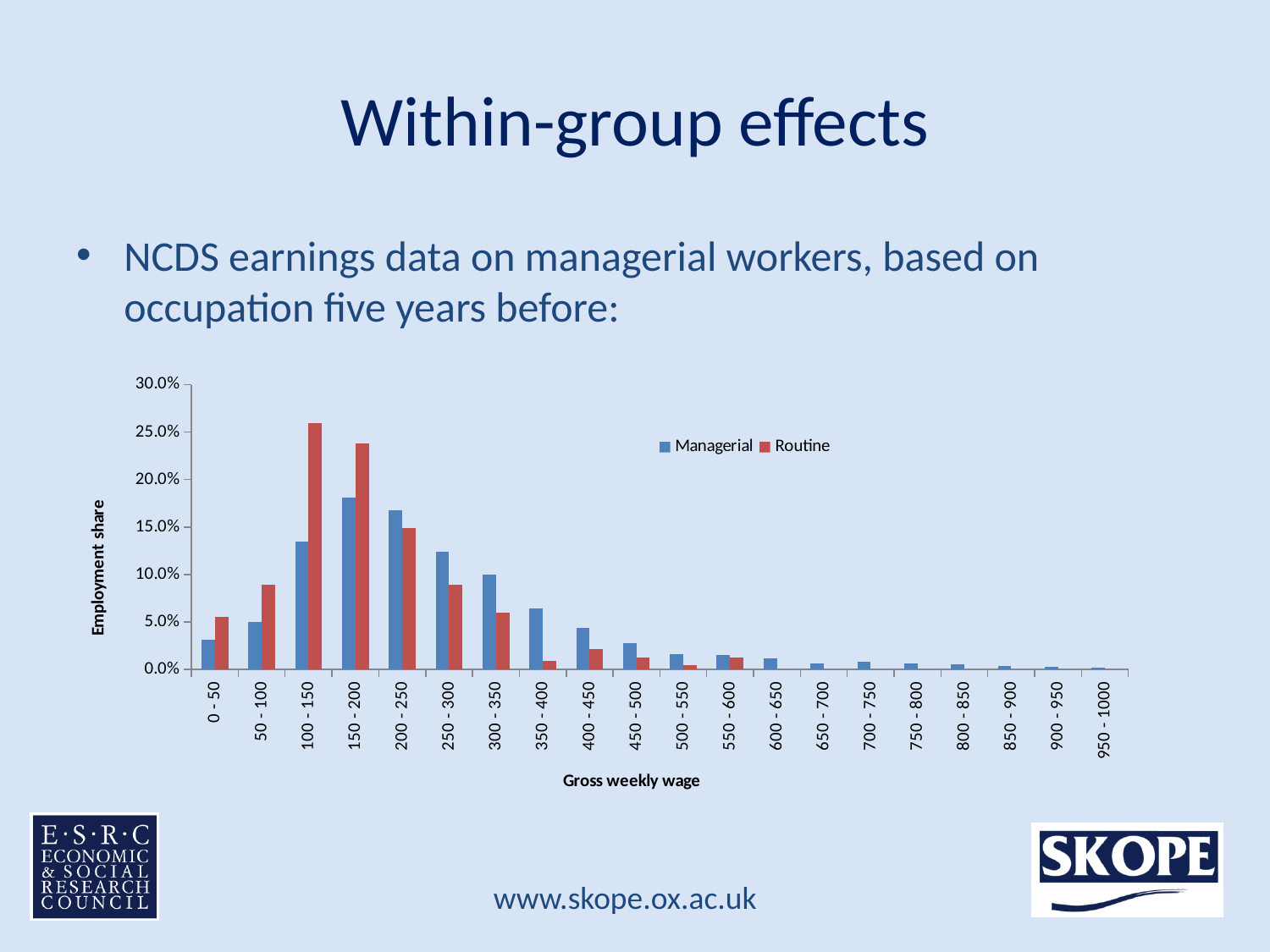
What is the label of the chart's horizontal axis? Gross weekly wage Which wage category has the highest employment share for the Routine series? 100 - 150 How many gross weekly wage categories are shown on the x axis? 20 What kind of chart is shown on the slide? bar chart In the 300 - 350 wage category, which series has the larger employment share, Managerial or Routine? Managerial How many series does the chart's legend list? 2 Which wage category has the highest employment share for the Managerial series? 150 - 200 What is the label of the chart's vertical axis? Employment share In the 100 - 150 wage category, which series has the larger employment share, Managerial or Routine? Routine Is the Managerial employment share for the 150 - 200 wage category greater or less than 15.0%? greater Is the Routine employment share for the 350 - 400 wage category greater or less than 5.0%? less Is the Routine employment share for the 150 - 200 wage category greater or less than 25.0%? less